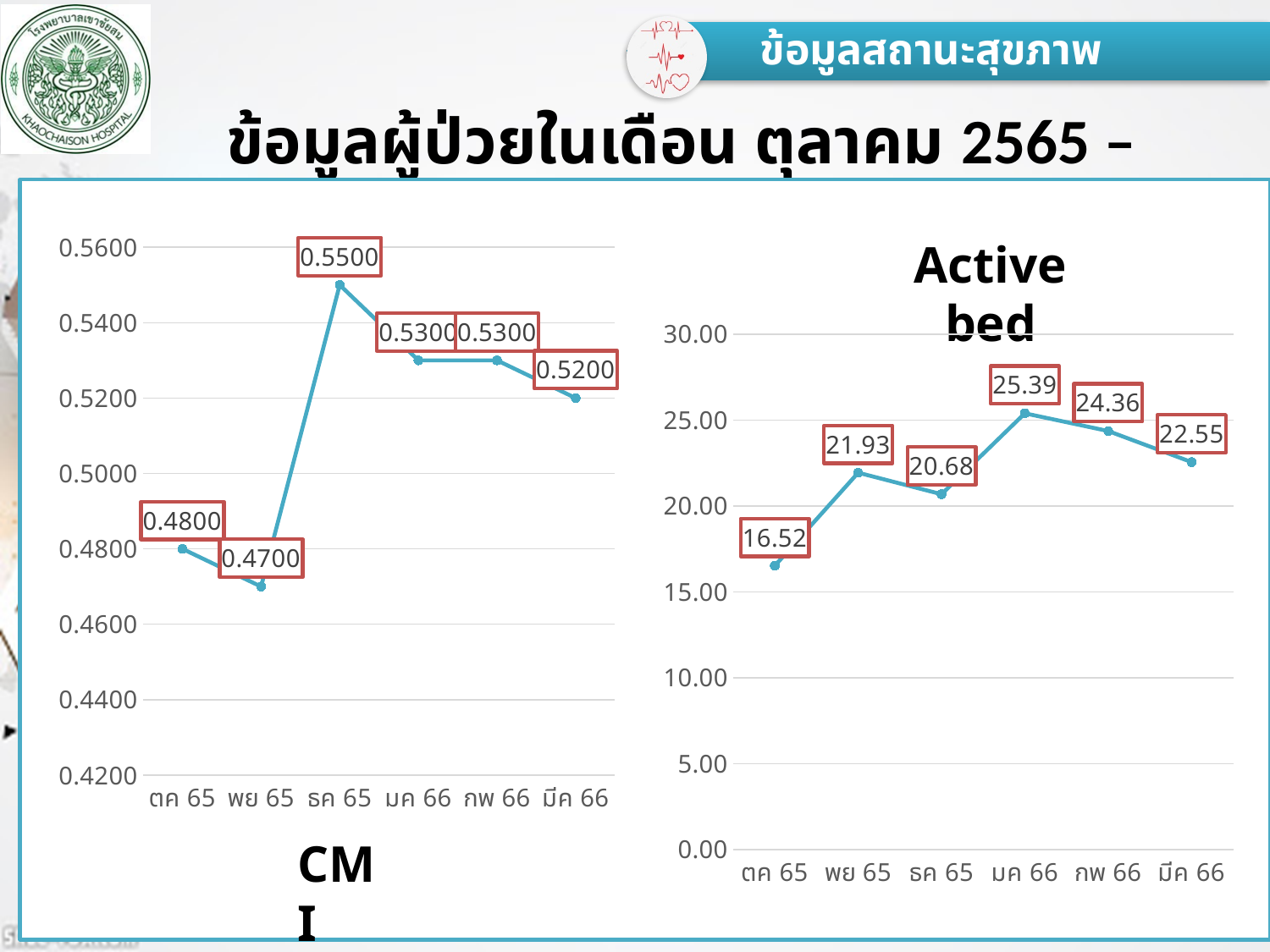
In the CMI chart on the left, what is the value for ธค 65? 0.5500 In the CMI chart on the left, which month has the highest value? ธค 65 In the Active bed chart on the right, what is the value for มค 66? 25.39 In the CMI chart on the left, what is the difference between the values for ธค 65 and พย 65? 0.0800 In the Active bed chart on the right, which is larger, the value for พย 65 or the value for ธค 65? พย 65 In the Active bed chart on the right, what is the value for ตค 65? 16.52 In the Active bed chart on the right, what is the difference between the values for มค 66 and มีค 66? 2.84 In the CMI chart on the left, what is the value for พย 65? 0.4700 In the CMI chart on the left, which month has the lowest value? พย 65 How many months are plotted in the Active bed chart on the right? 6 In the Active bed chart on the right, which month has the lowest value? ตค 65 What kind of chart is the CMI chart on the left? Line chart